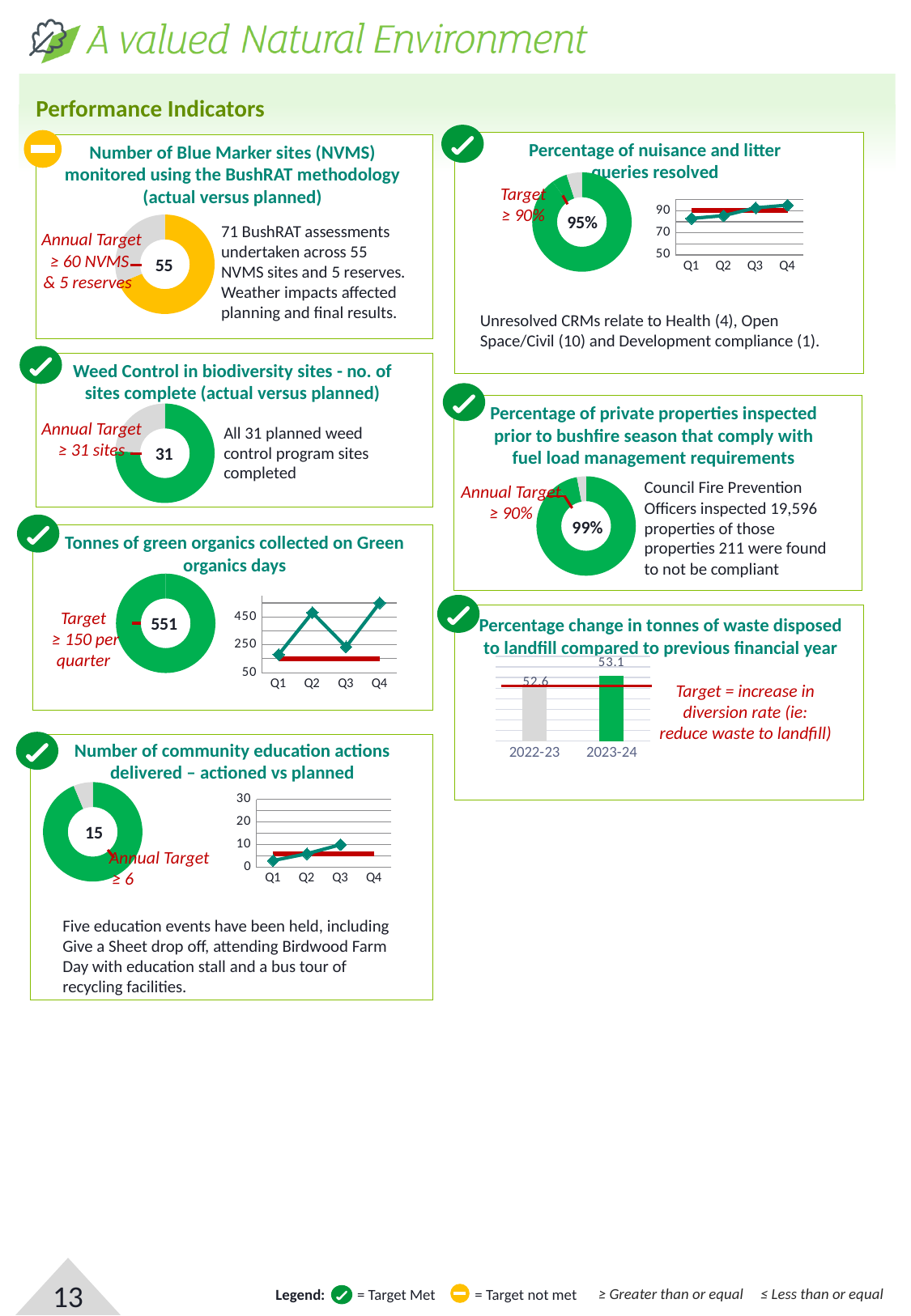
On the 'Percentage of nuisance and litter queries resolved' chart, what percentage is shown in the centre of the doughnut? 95% On the 'Percentage change in tonnes of waste disposed to landfill' bar chart, which year has the higher value? 2023-24 On the 'Percentage of private properties inspected prior to bushfire season' chart, what percentage is shown in the centre of the doughnut? 99% On the 'Weed Control in biodiversity sites' chart, what value is shown in the centre of the doughnut? 31 On the 'Percentage change in tonnes of waste disposed to landfill' bar chart, what is the value for 2023-24? 53.1 On the 'Number of Blue Marker sites (NVMS) monitored using the BushRAT methodology' chart, what value is shown in the centre of the doughnut? 55 On the 'Percentage of nuisance and litter queries resolved' line chart, is the value for Q1 greater or less than 90? less What kind of chart is used for 'Percentage change in tonnes of waste disposed to landfill compared to previous financial year'? bar chart On the 'Percentage change in tonnes of waste disposed to landfill' bar chart, what is the difference between the 2023-24 and 2022-23 values? 0.5 How many quarters are plotted on the x axis of the 'Number of community education actions delivered' line chart? 4 On the 'Tonnes of green organics collected' line chart, is the value for Q2 greater or less than 250? greater On the 'Tonnes of green organics collected on Green organics days' chart, what value is shown in the centre of the doughnut? 551